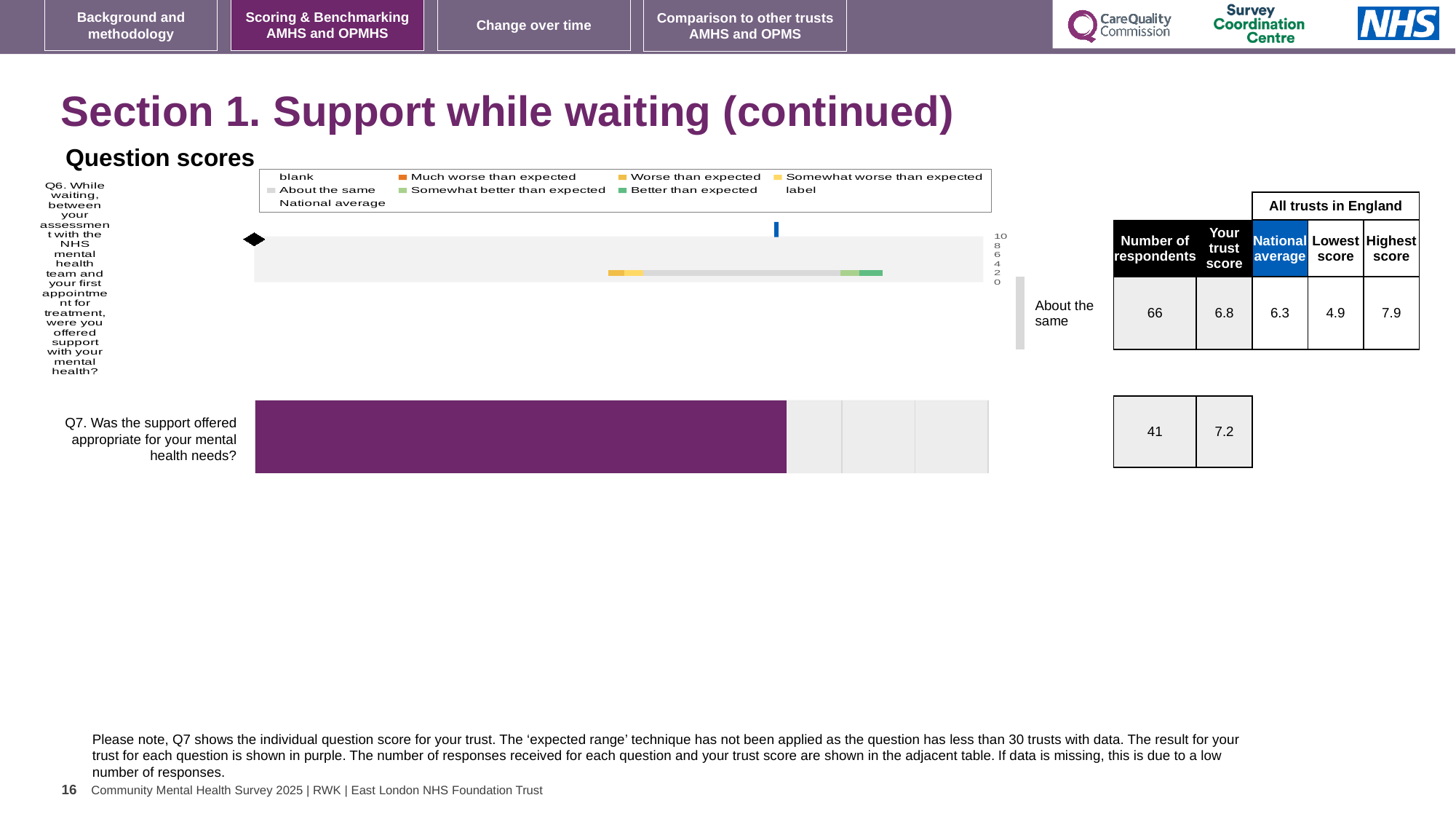
What is the difference between the trust score for Q6 and the national average for Q6? 0.5 What is the trust score for Q7? 7.2 What kind of chart is used to show the question scores on this slide? bar chart Which question has the higher trust score, Q6 or Q7? Q7 What category label is shown next to the Q6 bar in the chart? About the same How many questions are plotted in the question scores chart? 2 What is the lowest score among all trusts in England for Q6? 4.9 Is the purple bar for Q7 greater or less than 6 on the axis? greater What is the national average score for Q6? 6.3 How many respondents answered Q7? 41 What is the trust score for Q6 shown in the table next to the chart? 6.8 What is the highest score among all trusts in England for Q6? 7.9